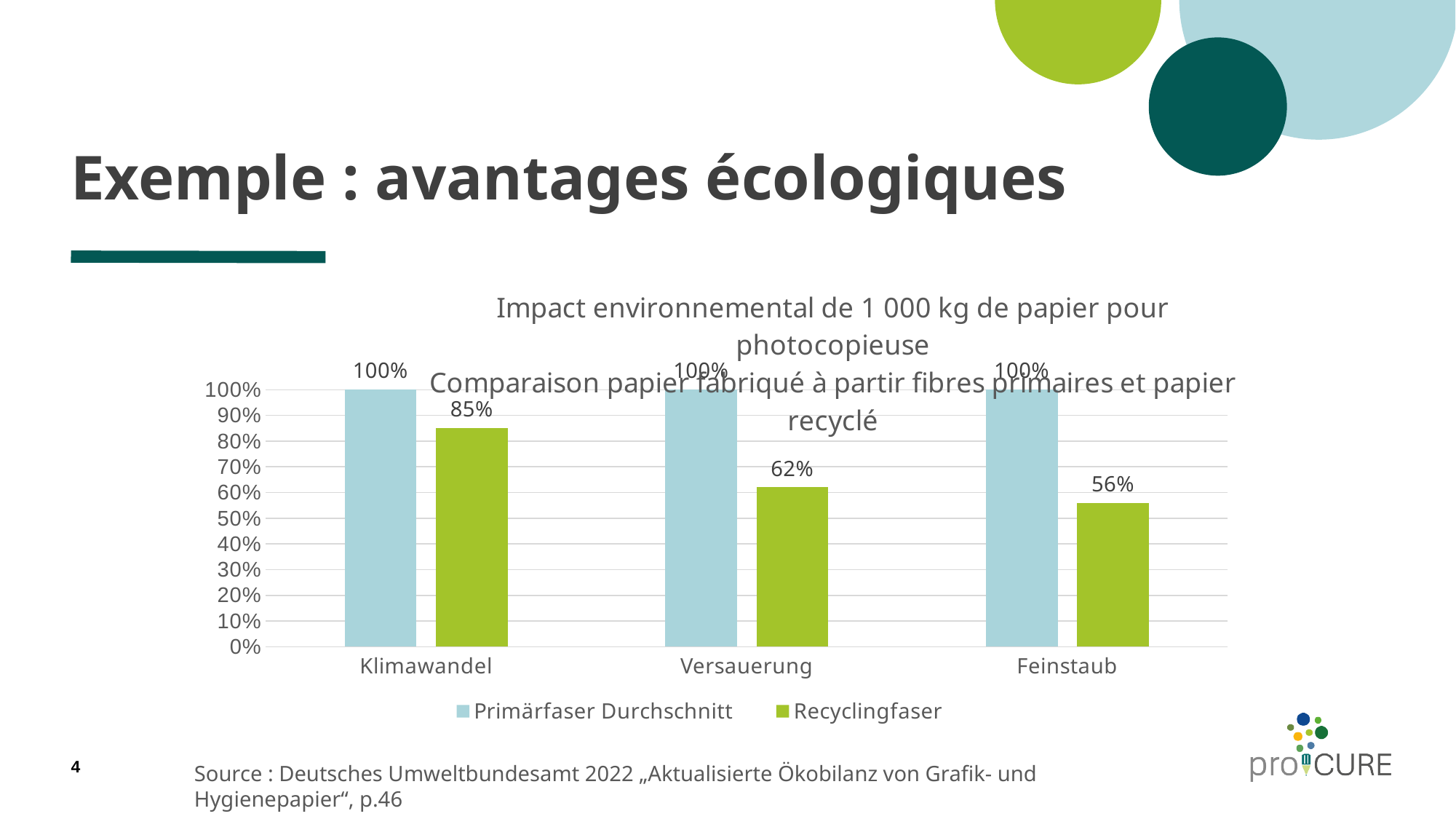
What is the value for Recyclingfaser in the Klimawandel category? 85% What is the difference between the Primärfaser Durchschnitt and Recyclingfaser values for Versauerung? 38% What is the value for Primärfaser Durchschnitt in the Feinstaub category? 100% Which is larger for Feinstaub: Primärfaser Durchschnitt or Recyclingfaser? Primärfaser Durchschnitt What kind of chart is shown on the slide? Bar chart How many series does the legend list? 2 What is the value for Recyclingfaser in the Versauerung category? 62% In which category is the Recyclingfaser value lowest? Feinstaub How many categories are shown on the x axis? 3 In which category is the Recyclingfaser value highest? Klimawandel What is the difference between the Recyclingfaser values for Klimawandel and Feinstaub? 29% What is the value for Recyclingfaser in the Feinstaub category? 56%